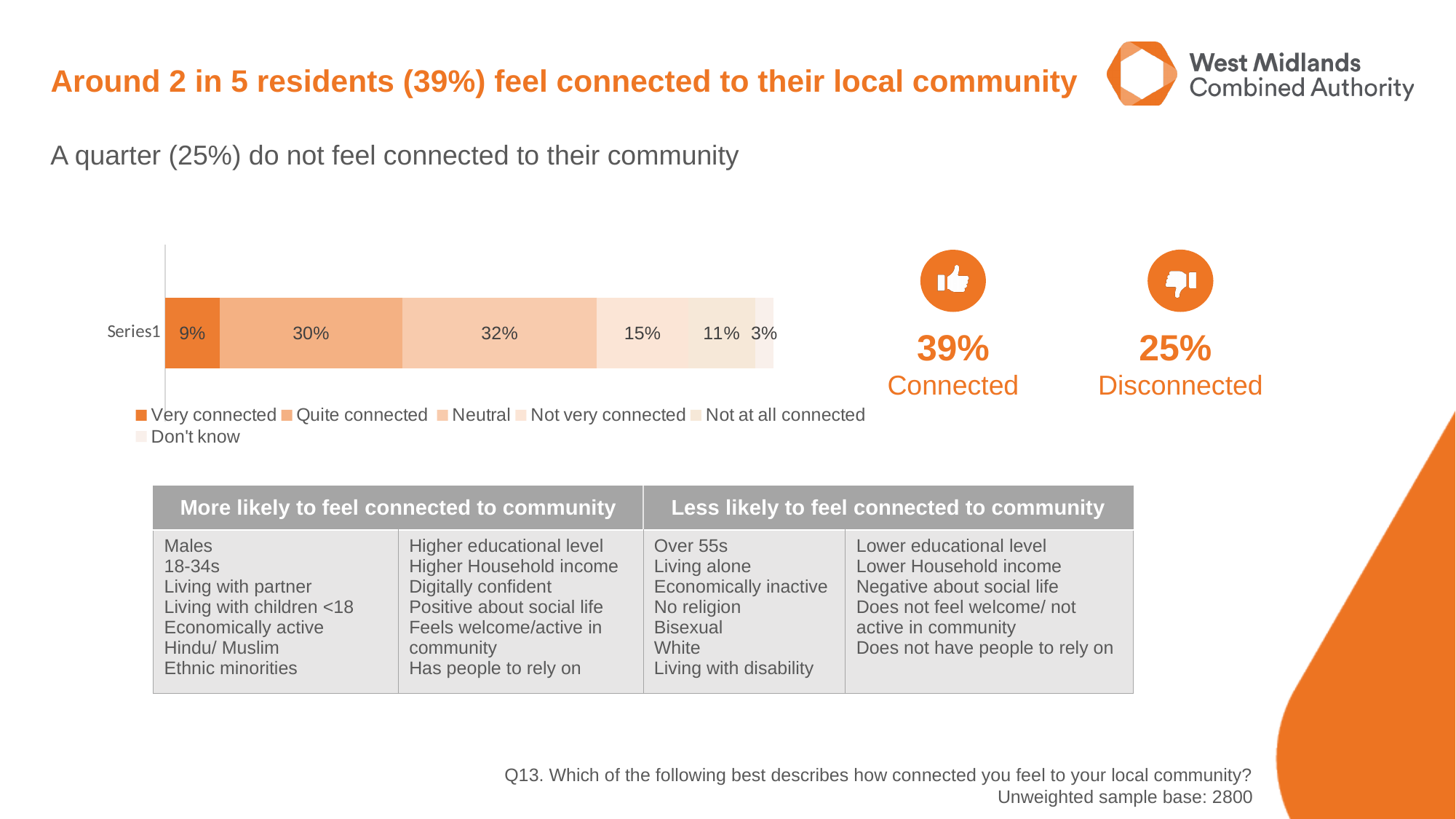
What type of chart is shown on the slide? Stacked bar chart What is the difference between the 'Quite connected' and 'Very connected' percentages? 21% What percentage of residents are 'Very connected' according to the chart? 9% What percentage of residents are 'Quite connected' according to the chart? 30% Which response category has the smallest share in the chart? Don't know How many series does the chart legend list? 6 What percentage of residents are 'Not very connected' according to the chart? 15% Which is larger: the 'Not very connected' share or the 'Not at all connected' share? Not very connected What is the combined total of 'Very connected' and 'Quite connected' in the chart? 39% What percentage of residents answered 'Don't know' in the chart? 3% What percentage of residents answered 'Neutral' in the chart? 32% Which response category has the largest share in the chart? Neutral